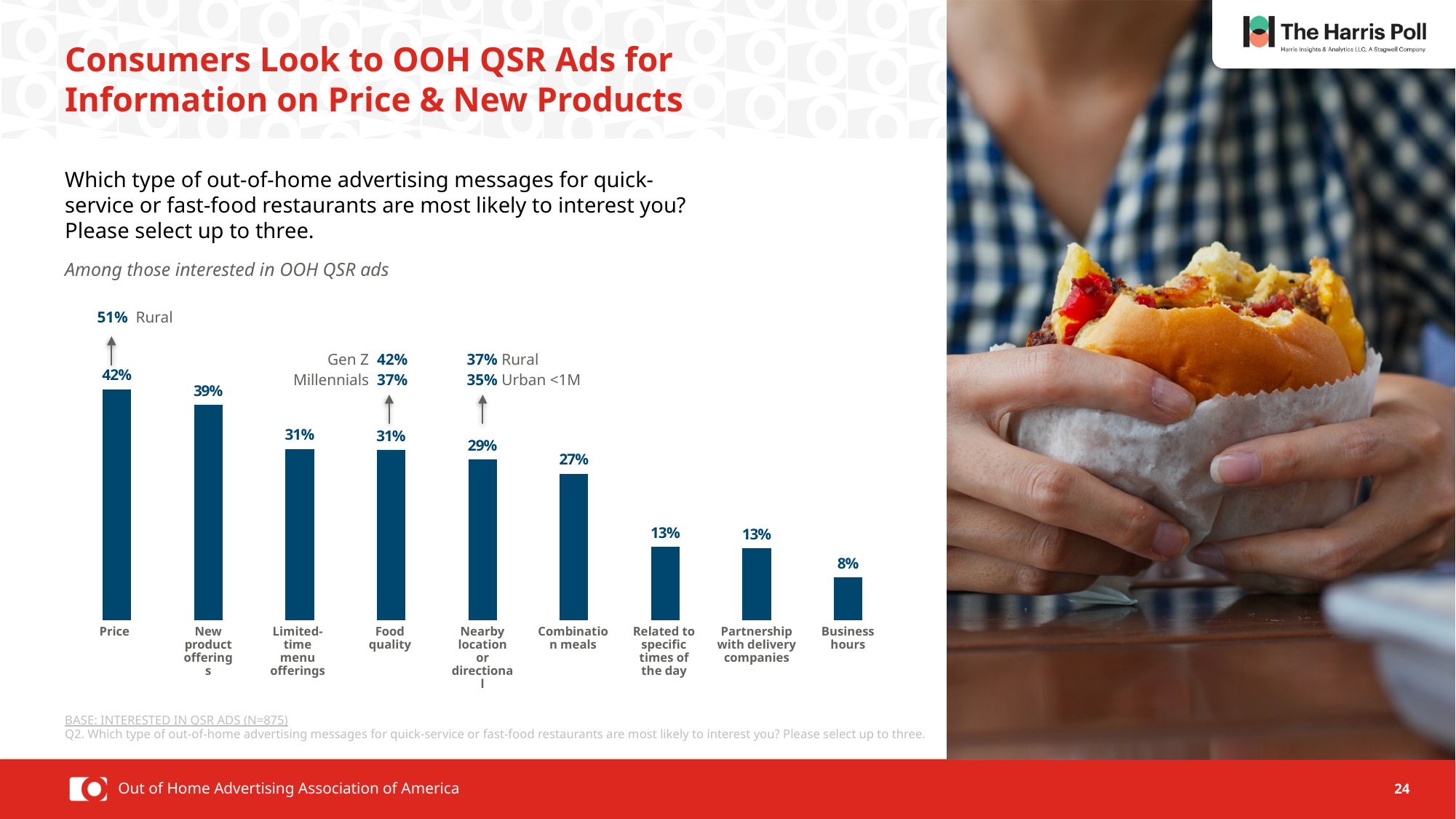
What is the difference between the values for Food quality and Business hours? 23% How many categories are shown in the bar chart? 9 Which is larger, the value for Nearby location or directional or the value for Combination meals? Nearby location or directional Do the values rise or fall moving from left to right across the categories? Fall According to the annotation above the Price bar, what percentage of Rural respondents selected Price? 51% What is the difference between the values for Price and New product offerings? 3% What is the value shown for Business hours? 8% What kind of chart is shown on the slide? Bar chart Which category has the highest value in the chart? Price Which category has the lowest value in the chart? Business hours What percentage of respondents selected Price as an OOH QSR ad message most likely to interest them? 42% What is the value shown for Combination meals? 27%